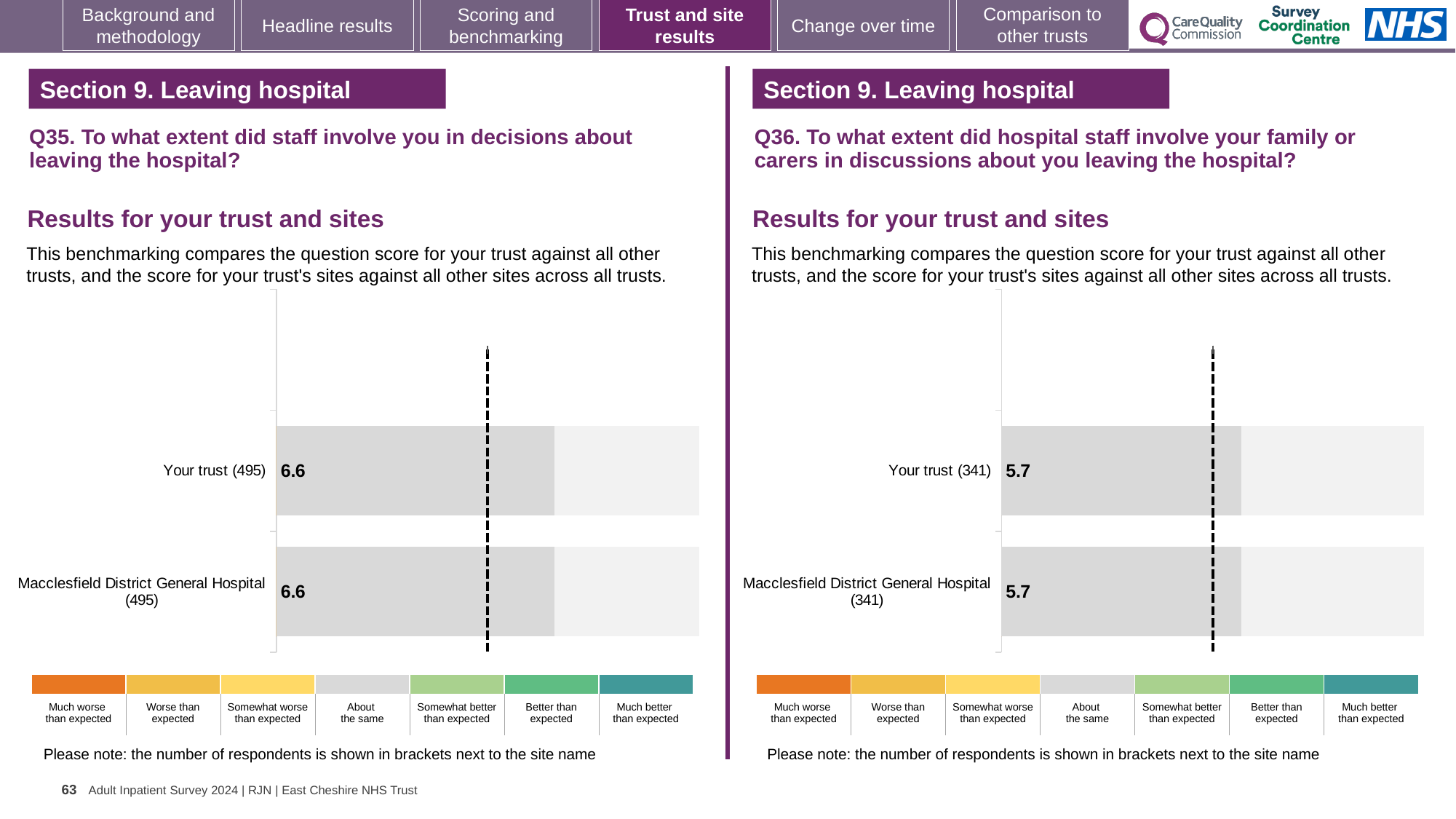
In the Q36 chart on the right, what is the score for Your trust? 5.7 In the Q35 chart on the left, what is the score for Your trust? 6.6 In the Q36 chart on the right, how many respondents are shown in brackets for Macclesfield District General Hospital? 341 In the Q36 chart on the right, what is the difference between the score for Your trust and the score for Macclesfield District General Hospital? 0 How many bars are plotted in the Q35 chart on the left? 2 In the Q36 chart on the right, what is the score for Macclesfield District General Hospital? 5.7 In the Q35 chart on the left, what is the difference between the score for Your trust and the score for Macclesfield District General Hospital? 0 In the Q35 chart on the left, what is the score for Macclesfield District General Hospital? 6.6 What kind of chart is used for the Q35 results on the left? Bar chart In the Q35 chart on the left, how many respondents are shown in brackets for Your trust? 495 How many bars are plotted in the Q36 chart on the right? 2